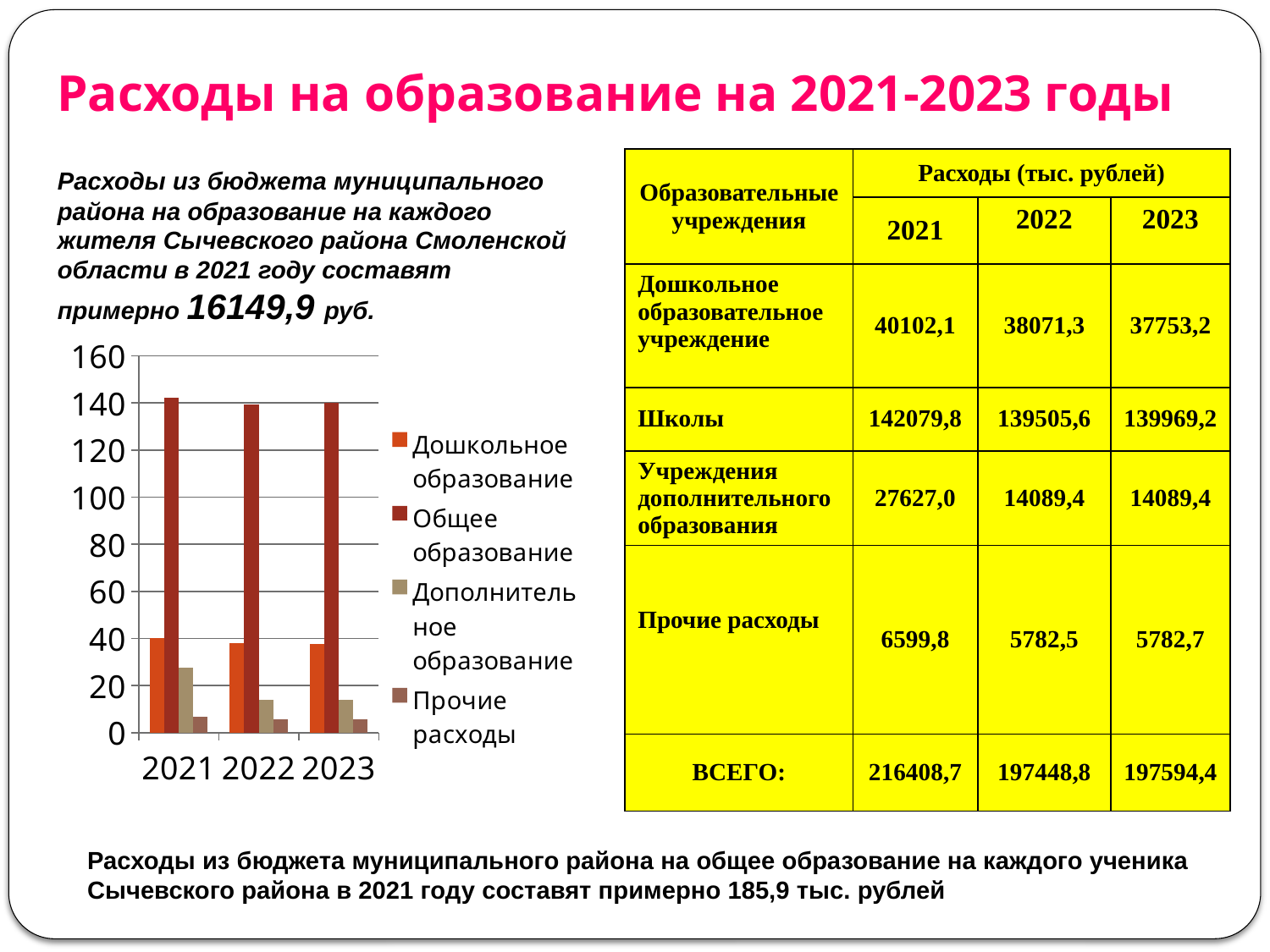
How many series does the chart legend list? 4 Which is larger in 2022: Дошкольное образование or Дополнительное образование? Дошкольное образование What is the highest value shown on the chart's vertical axis? 160 Which series has the tallest bar in 2021? Общее образование Does the value for Дополнительное образование rise or fall from 2021 to 2022? fall Is the value for Прочие расходы in 2021 greater or less than 20? less Which series has the shortest bar in 2023? Прочие расходы Is the value for Общее образование in 2021 greater or less than 120? greater What kind of chart is shown on the slide? bar chart Is the value for Дошкольное образование in 2023 greater or less than 20? greater How many years (categories) are shown on the x axis of the chart? 3